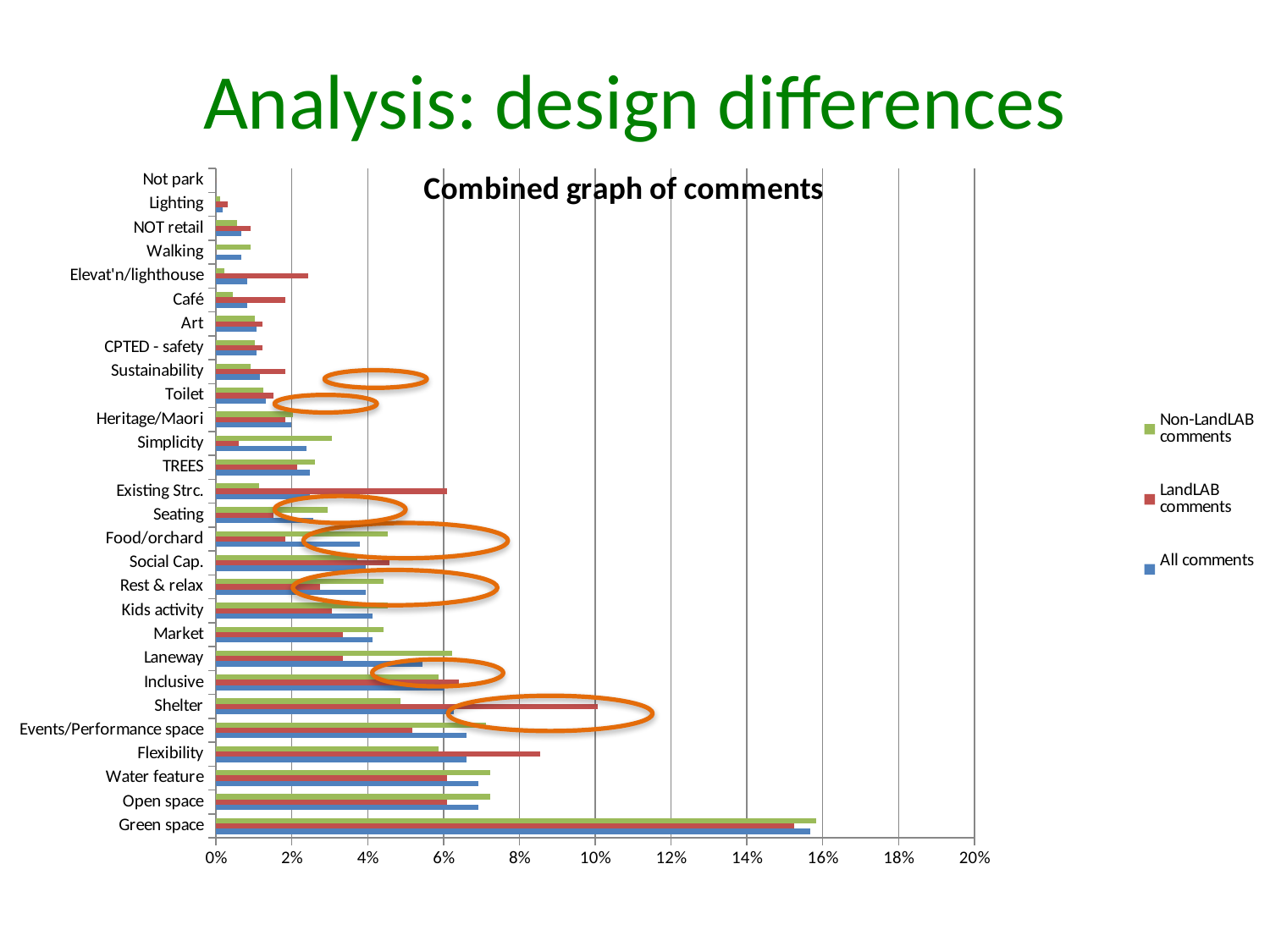
Is the Non-LandLAB comments value for Simplicity greater or less than 2%? greater Which category has the highest value for All comments? Green space Is the LandLAB comments value for Shelter greater or less than 8%? greater Is the LandLAB comments value for Flexibility greater or less than 8%? greater For Simplicity, which is larger: the Non-LandLAB comments value or the LandLAB comments value? Non-LandLAB comments What kind of chart is shown on the slide? Bar chart How many series does the chart's legend list? 3 For Shelter, which is larger: the LandLAB comments value or the Non-LandLAB comments value? LandLAB comments How many categories are shown on the chart's vertical axis? 28 For Existing Strc., which is larger: the LandLAB comments value or the Non-LandLAB comments value? LandLAB comments What is the title of the chart? Combined graph of comments